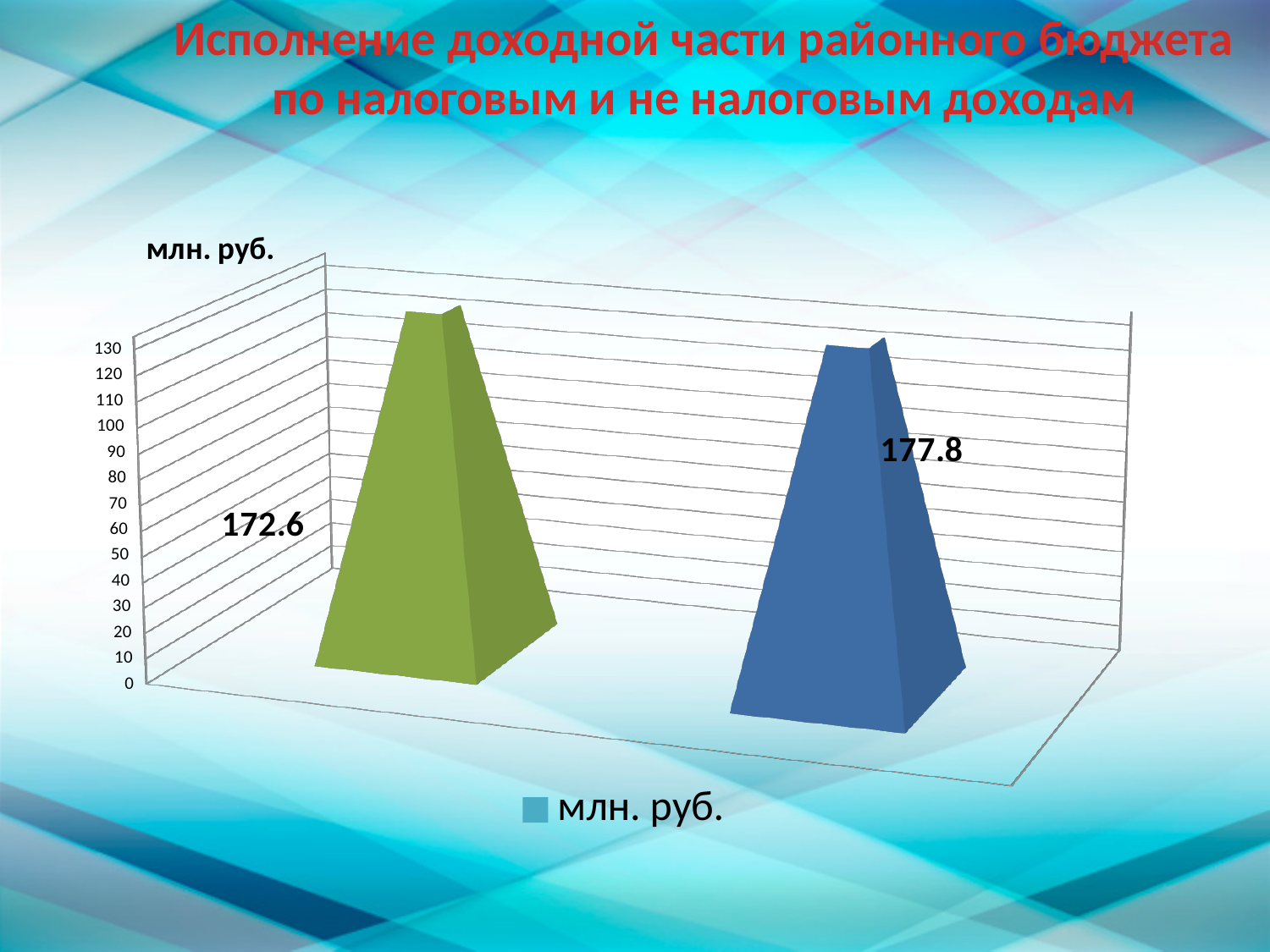
What is the title of the slide? Исполнение доходной части районного бюджета по налоговым и не налоговым доходам What is the data label on the left (green) bar? 172.6 What is the difference between the two labelled values, 177.8 and 172.6? 5.2 What is the data label on the right (blue) bar? 177.8 What is the highest tick value shown on the vertical axis? 130 According to the data labels, which bar has the larger value, the green one or the blue one? the blue one (177.8) How many series does the legend list? 1 How many bars are plotted on the chart? 2 What entry does the legend show? млн. руб. What kind of chart is shown on the slide? bar chart